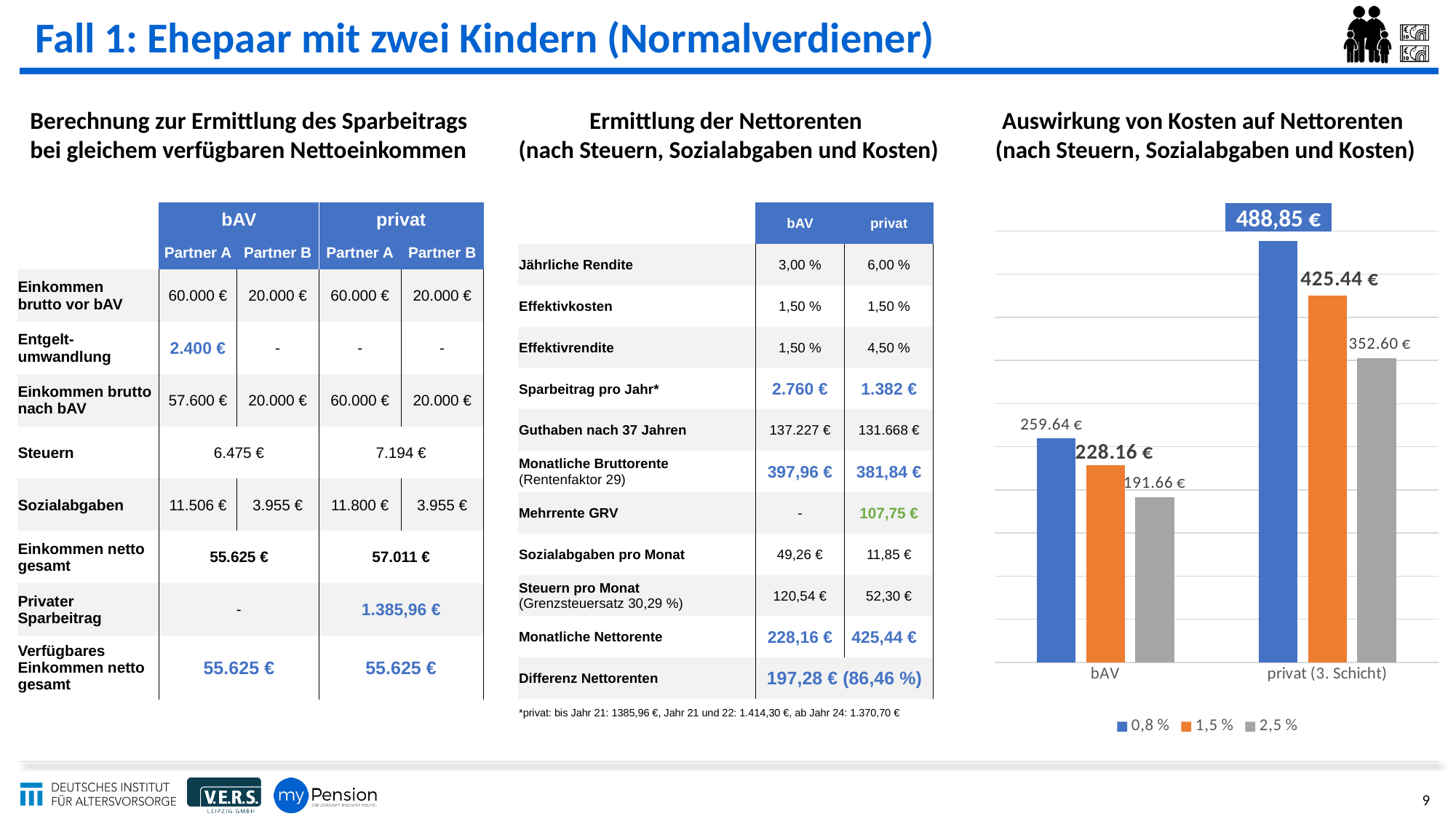
In the chart 'Auswirkung von Kosten auf Nettorenten', what is the difference between the 1,5 % and 2,5 % values for privat (3. Schicht)? 72.84 € In the chart 'Auswirkung von Kosten auf Nettorenten', what is the difference between the 0,8 % and 1,5 % values for bAV? 31.48 € In the chart 'Auswirkung von Kosten auf Nettorenten', which bar has the highest value? 0,8 % for privat (3. Schicht) What kind of chart is 'Auswirkung von Kosten auf Nettorenten'? Bar chart In the chart 'Auswirkung von Kosten auf Nettorenten', what is the value of the 0,8 % series for bAV? 259.64 € In the chart 'Auswirkung von Kosten auf Nettorenten', what is the value of the 2,5 % series for bAV? 191.66 € In the chart 'Auswirkung von Kosten auf Nettorenten', which bar has the lowest value? 2,5 % for bAV How many categories are shown on the x axis of the chart 'Auswirkung von Kosten auf Nettorenten'? 2 How many series does the legend of the chart 'Auswirkung von Kosten auf Nettorenten' list? 3 In the chart 'Auswirkung von Kosten auf Nettorenten', what is the value of the 0,8 % series for privat (3. Schicht)? 488,85 € In the chart 'Auswirkung von Kosten auf Nettorenten', what is the value of the 1,5 % series for privat (3. Schicht)? 425.44 € In the chart 'Auswirkung von Kosten auf Nettorenten', which is larger: the 2,5 % value for privat (3. Schicht) or the 0,8 % value for bAV? 2,5 % for privat (3. Schicht)